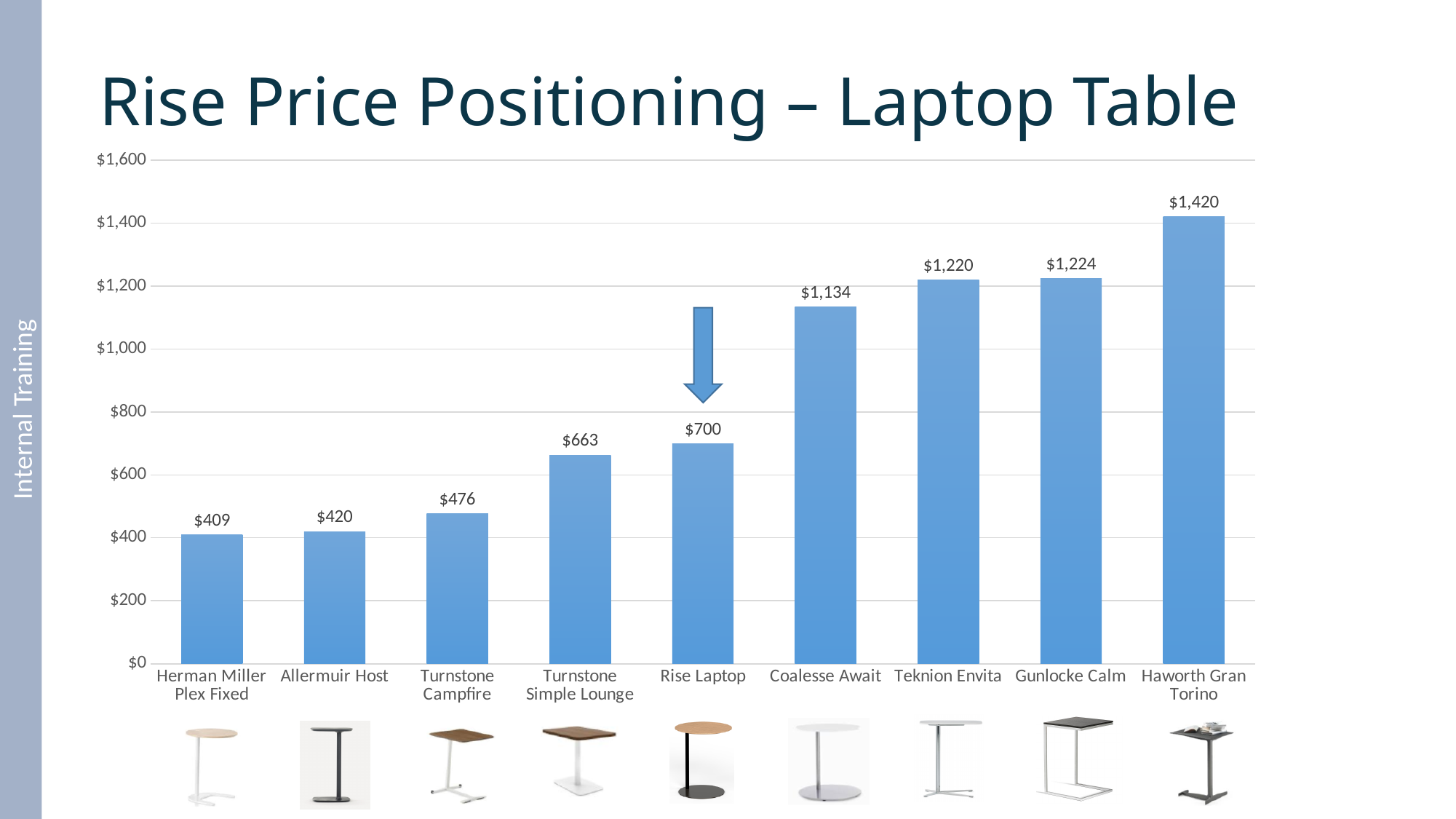
Which product has the lowest price on the chart? Herman Miller Plex Fixed What is the difference in price between Haworth Gran Torino and Rise Laptop? $720 How many products are shown on the chart? 9 Which product has the highest price on the chart? Haworth Gran Torino Is the value for Coalesse Await greater or less than $1,000? greater Which is priced higher, Allermuir Host or Turnstone Campfire? Turnstone Campfire What is the price shown for Coalesse Await? $1,134 What kind of chart is shown on the slide? Bar chart What is the price shown for Rise Laptop? $700 Do the prices rise or fall moving from left to right across the chart? Rise What is the price shown for Turnstone Campfire? $476 What is the difference in price between Rise Laptop and Turnstone Simple Lounge? $37